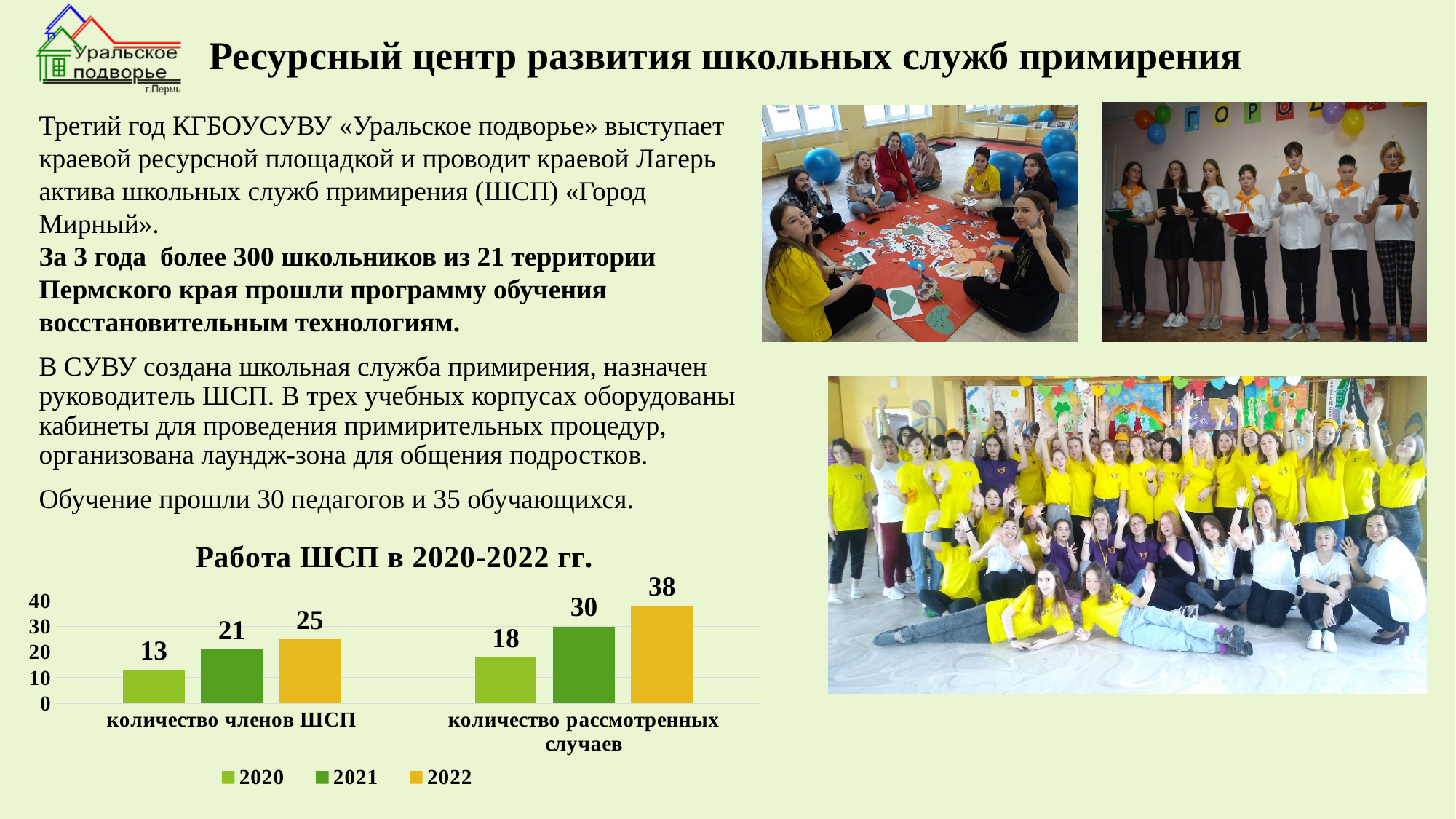
Which is larger: the 2022 value for 'количество членов ШСП' or the 2021 value for 'количество рассмотренных случаев'? 2021 value for количество рассмотренных случаев What is the value for 'количество членов ШСП' in 2020? 13 What is the value for 'количество рассмотренных случаев' in 2022? 38 Which year has the highest value for 'количество рассмотренных случаев'? 2022 What is the value for 'количество членов ШСП' in 2021? 21 How many series does the chart legend list? 3 What type of chart is shown on the slide? bar chart What is the title of the chart? Работа ШСП в 2020-2022 гг. What is the difference between the 2022 and 2020 values for 'количество рассмотренных случаев'? 20 How many categories are shown on the x axis of the chart? 2 Do the values for 'количество членов ШСП' rise or fall from 2020 to 2022? rise Which year has the lowest value for 'количество членов ШСП'? 2020